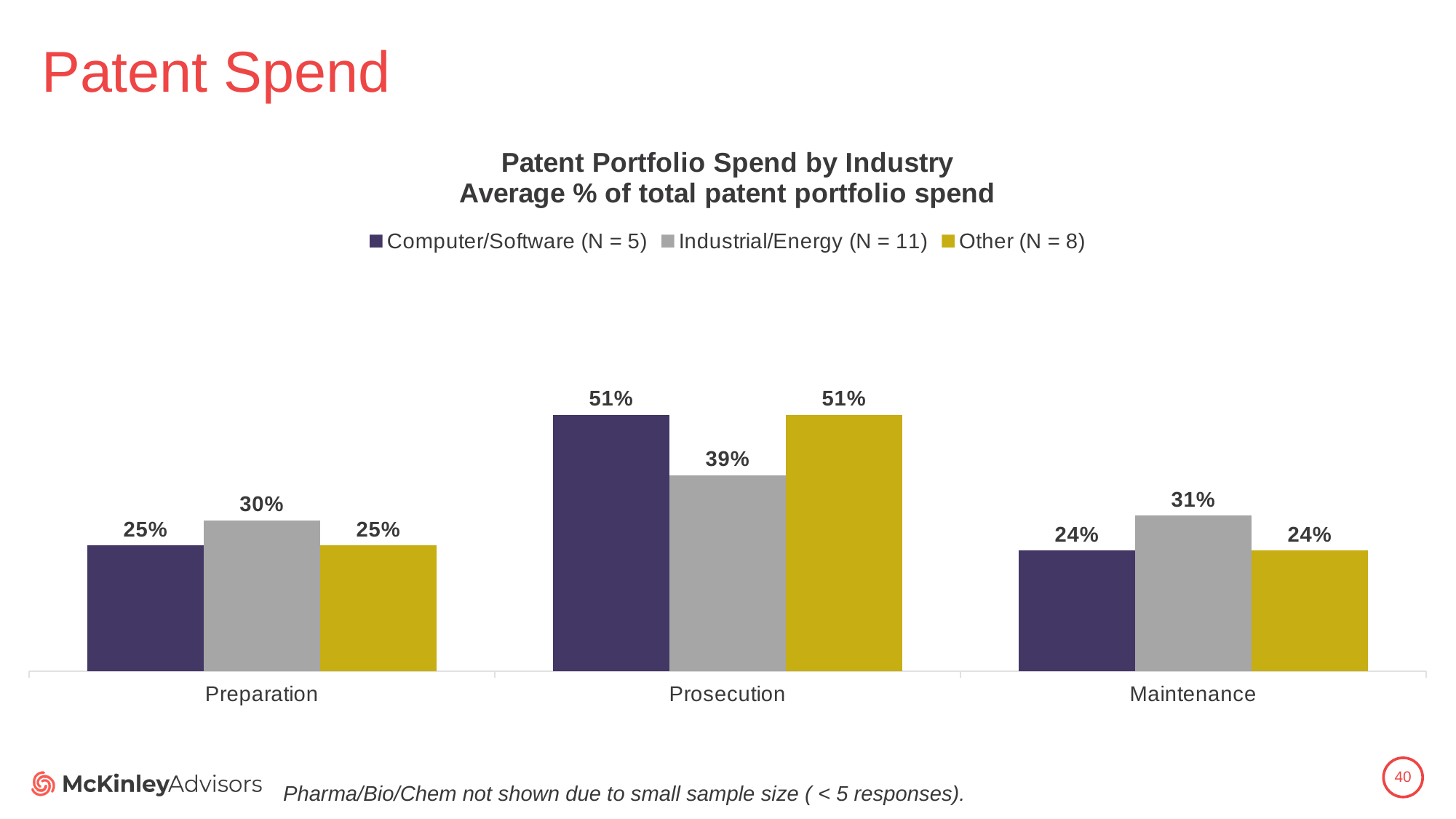
What is the title of the chart? Patent Portfolio Spend by Industry Average % of total patent portfolio spend What kind of chart is shown on the slide? Bar chart How many categories are shown on the x axis? 3 Which category has the lowest value for Computer/Software (N = 5)? Maintenance What is the value for Other (N = 8) in the Maintenance category? 24% Which category has the highest value for Industrial/Energy (N = 11)? Prosecution How many series does the legend list? 3 What is the value for Industrial/Energy (N = 11) in the Preparation category? 30% What is the difference between the Computer/Software (N = 5) and Industrial/Energy (N = 11) values in the Prosecution category? 12% In the Preparation category, which is larger: Industrial/Energy (N = 11) or Other (N = 8)? Industrial/Energy (N = 11) What is the value for Industrial/Energy (N = 11) in the Maintenance category? 31% What is the value for Computer/Software (N = 5) in the Prosecution category? 51%